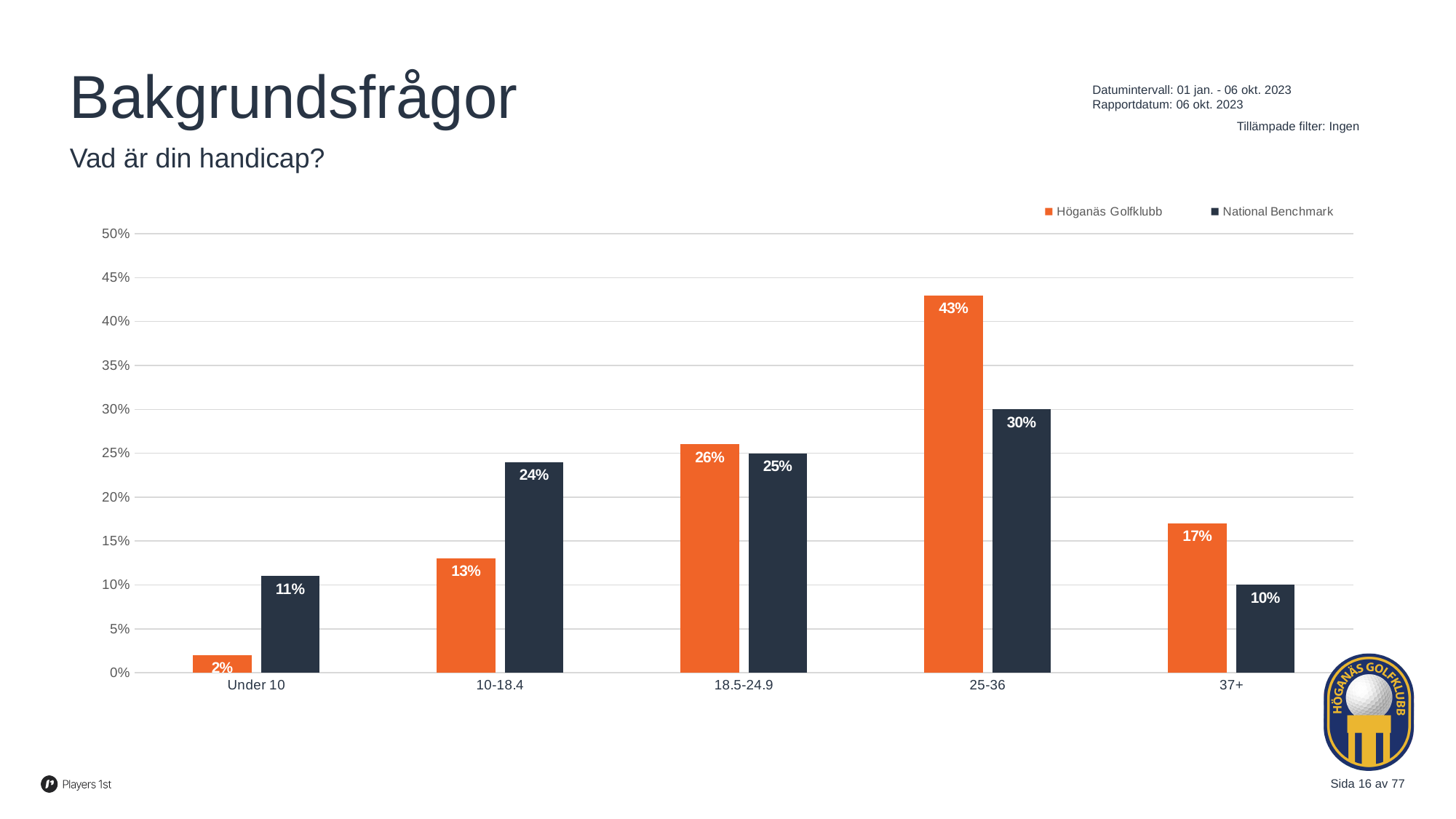
What is the Höganäs Golfklubb value for the Under 10 category? 2% How many handicap categories are shown on the x axis? 5 How many series does the legend list? 2 What is the Höganäs Golfklubb value for the 25-36 handicap category? 43% Which colour represents Höganäs Golfklubb in the chart? Orange Which handicap category has the lowest National Benchmark value? 37+ What is the difference between the Höganäs Golfklubb and National Benchmark values for the 25-36 category? 13% Is the Höganäs Golfklubb value for 37+ greater or less than 15%? greater For the Under 10 category, which is larger: Höganäs Golfklubb or National Benchmark? National Benchmark Which handicap category has the highest Höganäs Golfklubb value? 25-36 What kind of chart is shown on the slide? Bar chart What is the National Benchmark value for the 10-18.4 handicap category? 24%